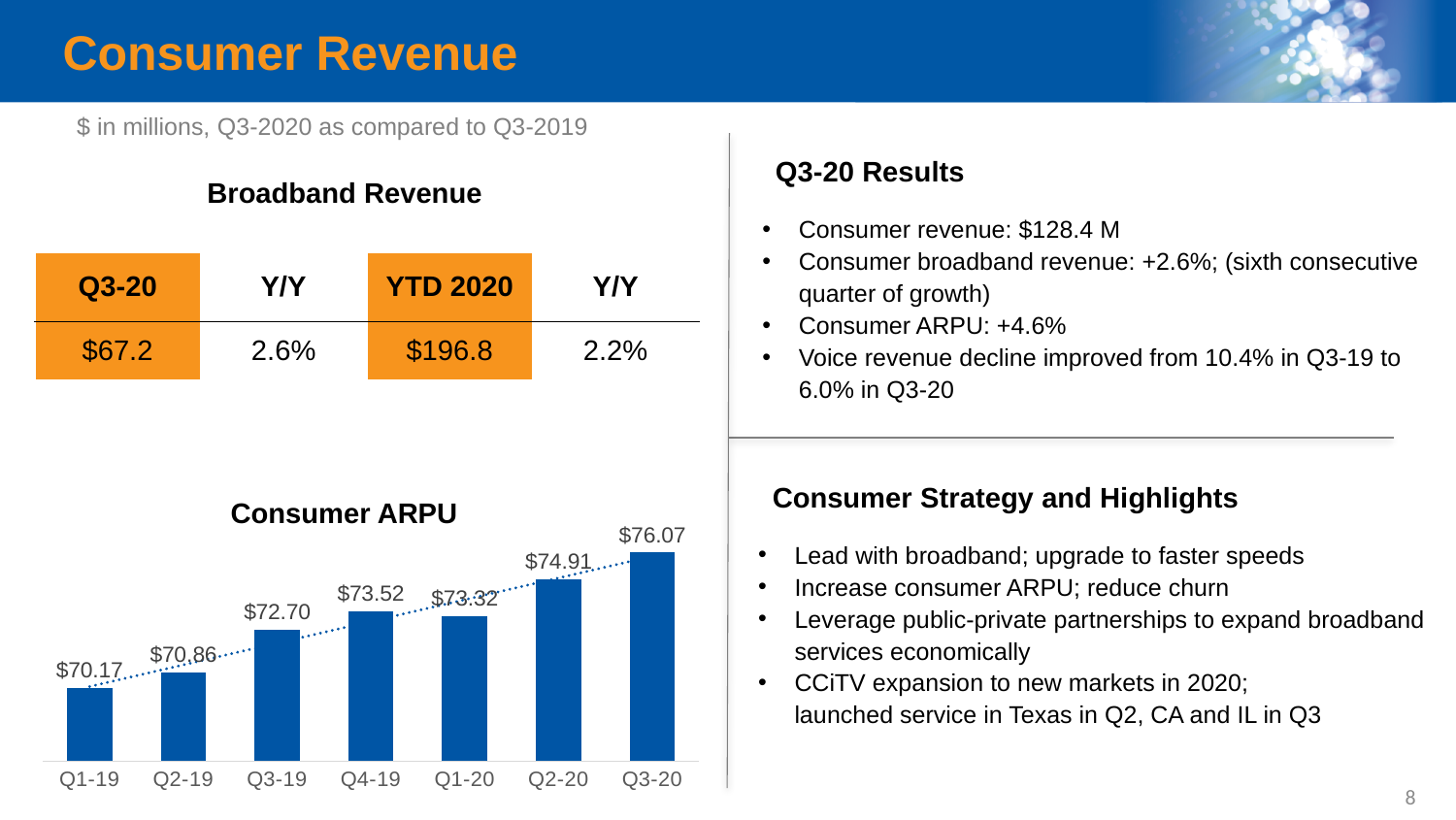
How many quarters are shown in the Consumer ARPU chart? 7 In the Consumer ARPU chart, which is larger, the value for Q4-19 or the value for Q1-20? Q4-19 In the Consumer ARPU chart, what is the value for Q1-19? $70.17 In the Consumer ARPU chart, which is larger, the value for Q2-19 or the value for Q2-20? Q2-20 In the Consumer ARPU chart, do the values generally rise or fall from Q1-19 to Q3-20? Rise In the Consumer ARPU chart, what is the difference between the Q3-20 value and the Q1-19 value? $5.90 In the Consumer ARPU chart, which quarter has the lowest value? Q1-19 In the Consumer ARPU chart, what is the value for Q4-19? $73.52 In the Consumer ARPU chart, what is the value for Q3-20? $76.07 In the Consumer ARPU chart, what is the difference between the Q3-20 value and the Q3-19 value? $3.37 In the Consumer ARPU chart, which quarter has the highest value? Q3-20 What kind of chart is the Consumer ARPU chart? Bar chart